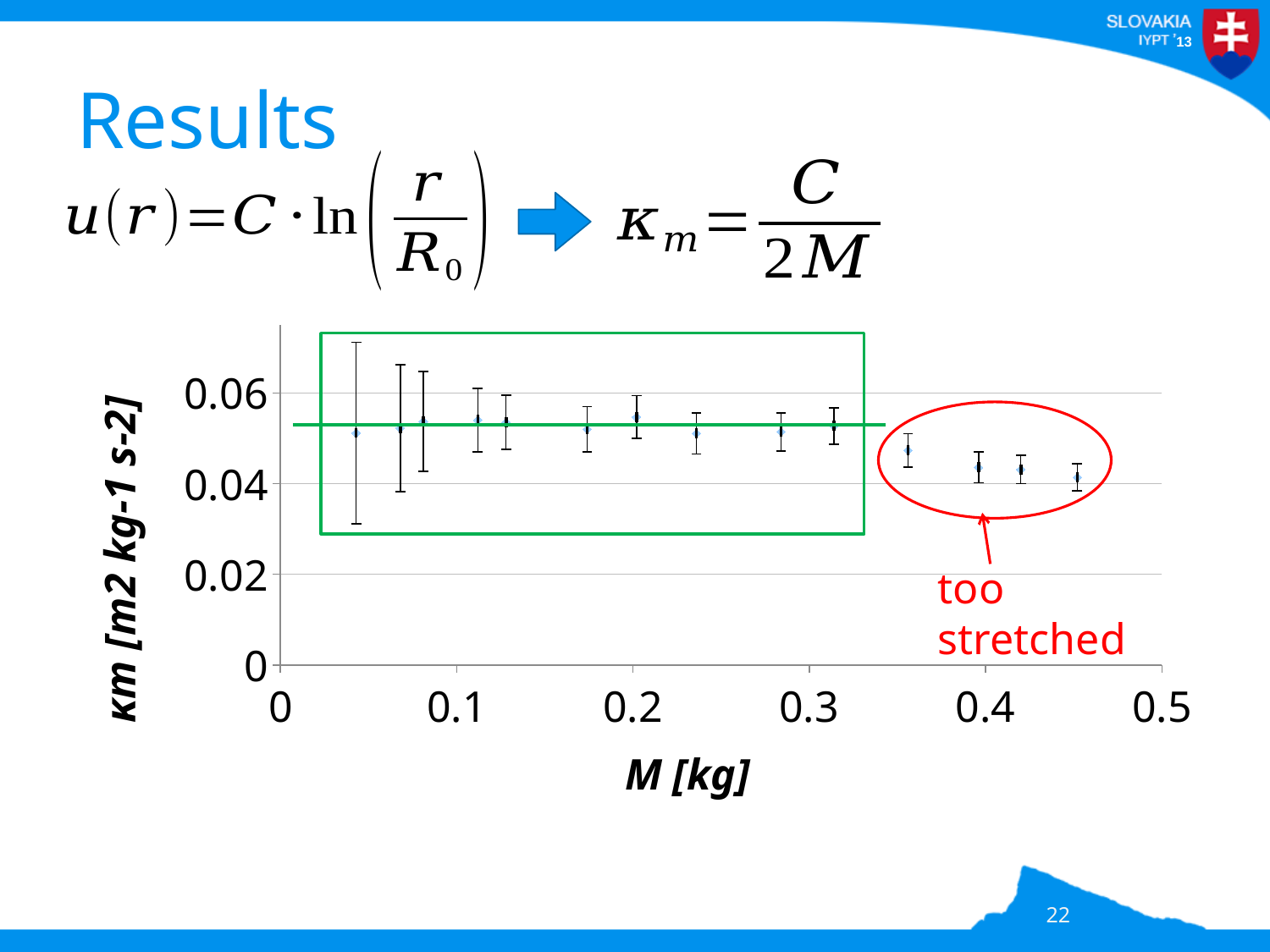
Is the value for the data point at M ≈ 0.2 kg greater or less than 0.04? greater What is the maximum value shown on the x axis of the chart? 0.5 Is the value for the data point at M ≈ 0.2 kg greater or less than 0.06? less How many data points are enclosed by the red ellipse labelled 'too stretched'? 4 Which data point has a larger κm value: the one at M ≈ 0.2 kg or the one at M ≈ 0.45 kg? M ≈ 0.2 kg Do the plotted κm values rise or fall for the points at M above 0.35 kg compared with the points inside the green box? fall Is the value for the data point at M ≈ 0.3 kg greater or less than 0.02? greater What is the label of the x axis of the chart? M [kg] What annotation text is written next to the red ellipse on the chart? too stretched What kind of chart is shown on the slide? scatter plot with error bars